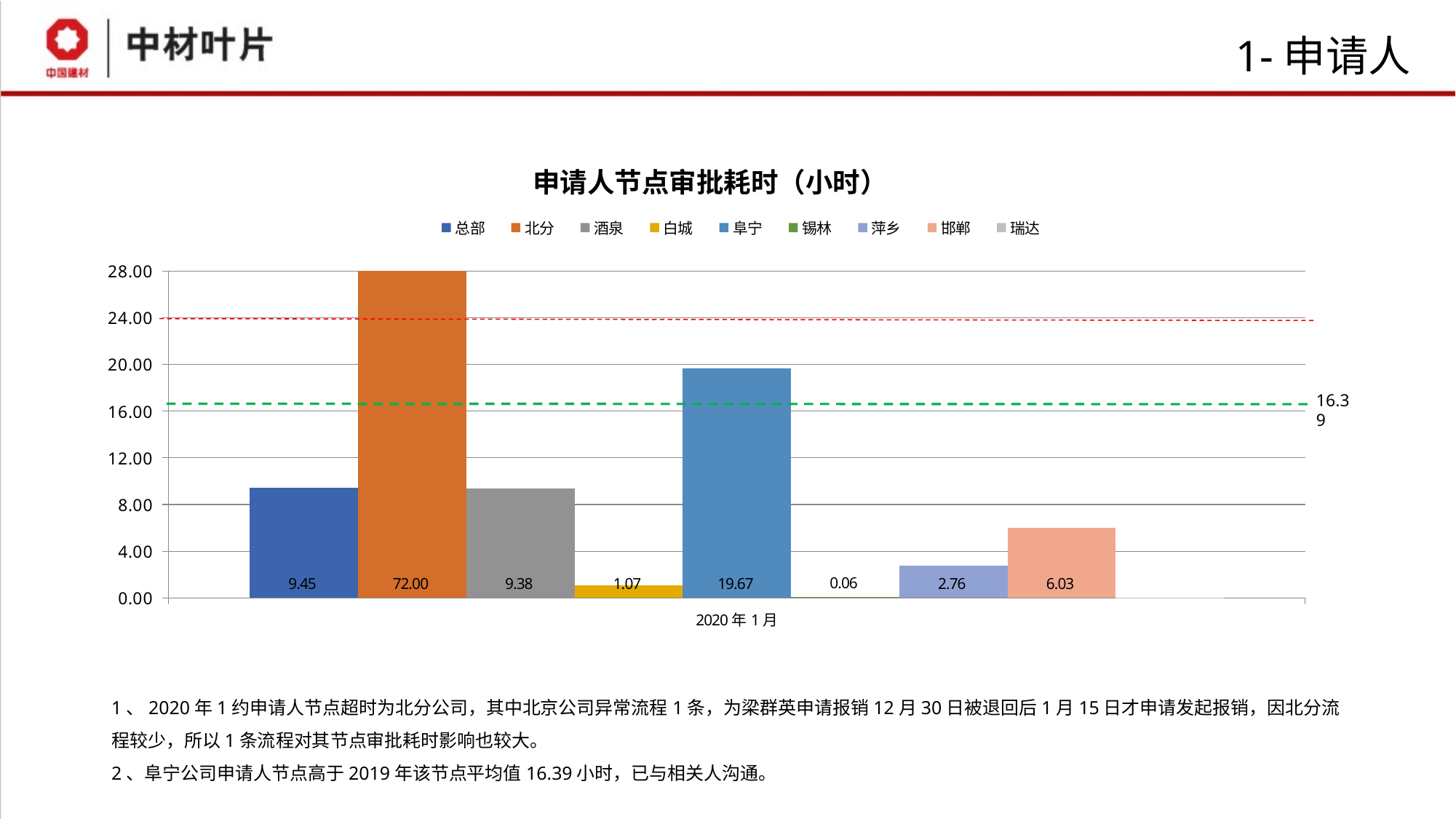
How many series does the legend list? 9 What is the value for 阜宁 in the chart? 19.67 What is the difference between the values for 北分 and 阜宁? 52.33 What is the value for 北分 in the chart? 72.00 What is the value for 邯郸 in the chart? 6.03 Which series has the highest value in the chart? 北分 What is the difference between the values for 总部 and 酒泉? 0.07 What is the value for 锡林 in the chart? 0.06 What kind of chart is shown on the slide? bar chart Among the series with data labels shown, which has the lowest value? 锡林 Which is larger, the value for 邯郸 or the value for 萍乡? 邯郸 What value is labelled on the green dashed horizontal line in the chart? 16.39